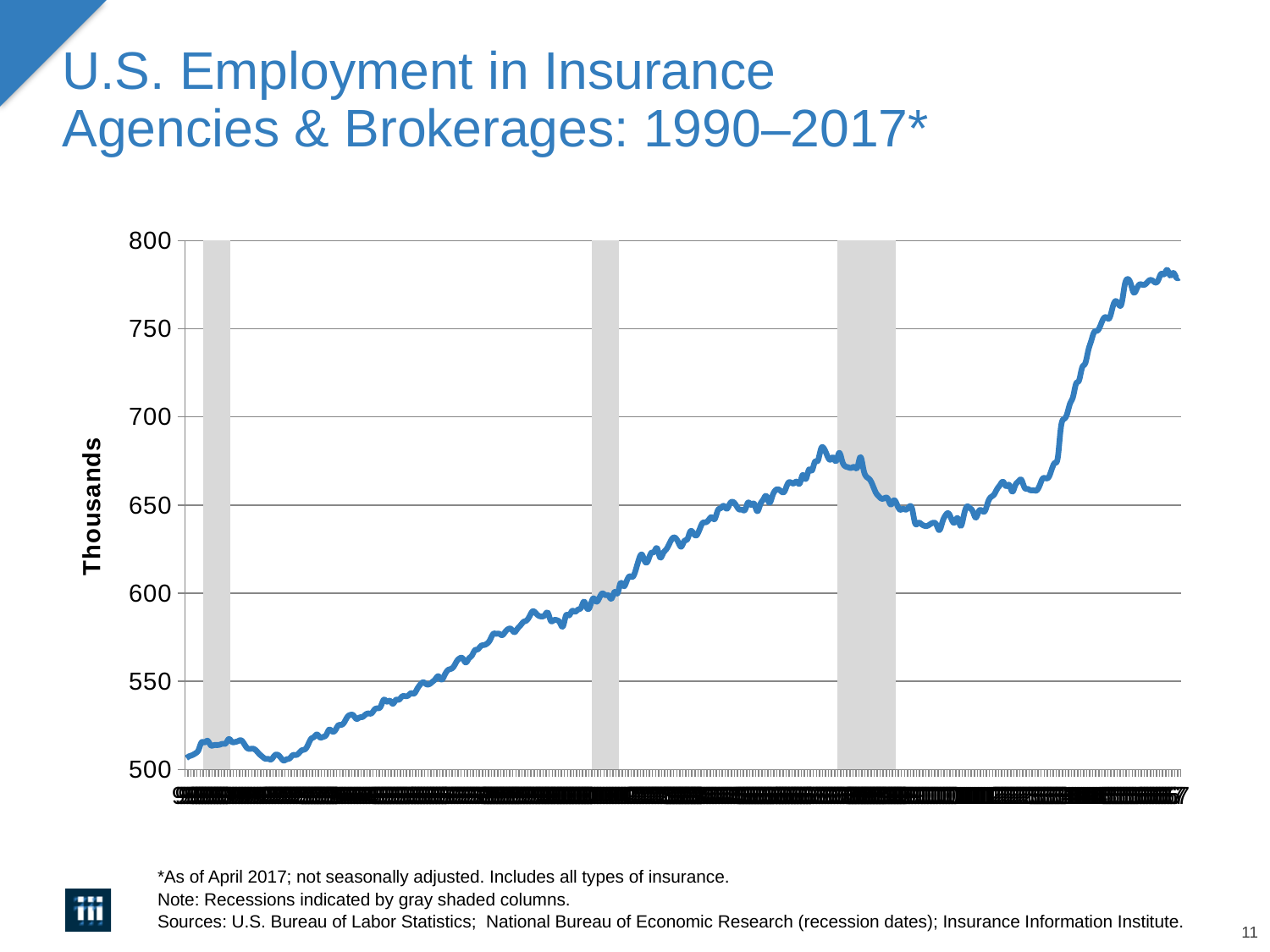
Is the lowest point on the line greater or less than 550? less Is the highest point reached by the line greater or less than 750? greater How many lines (data series) are plotted on the chart? 1 What is the label on the vertical axis of the chart? Thousands Is the peak of the line just before the third gray shaded recession column greater or less than 700? less What kind of chart is shown on the slide? line chart Overall, does the line rise or fall from the left end of the chart to the right end? rise What is the title of the chart on the slide? U.S. Employment in Insurance Agencies & Brokerages: 1990–2017*